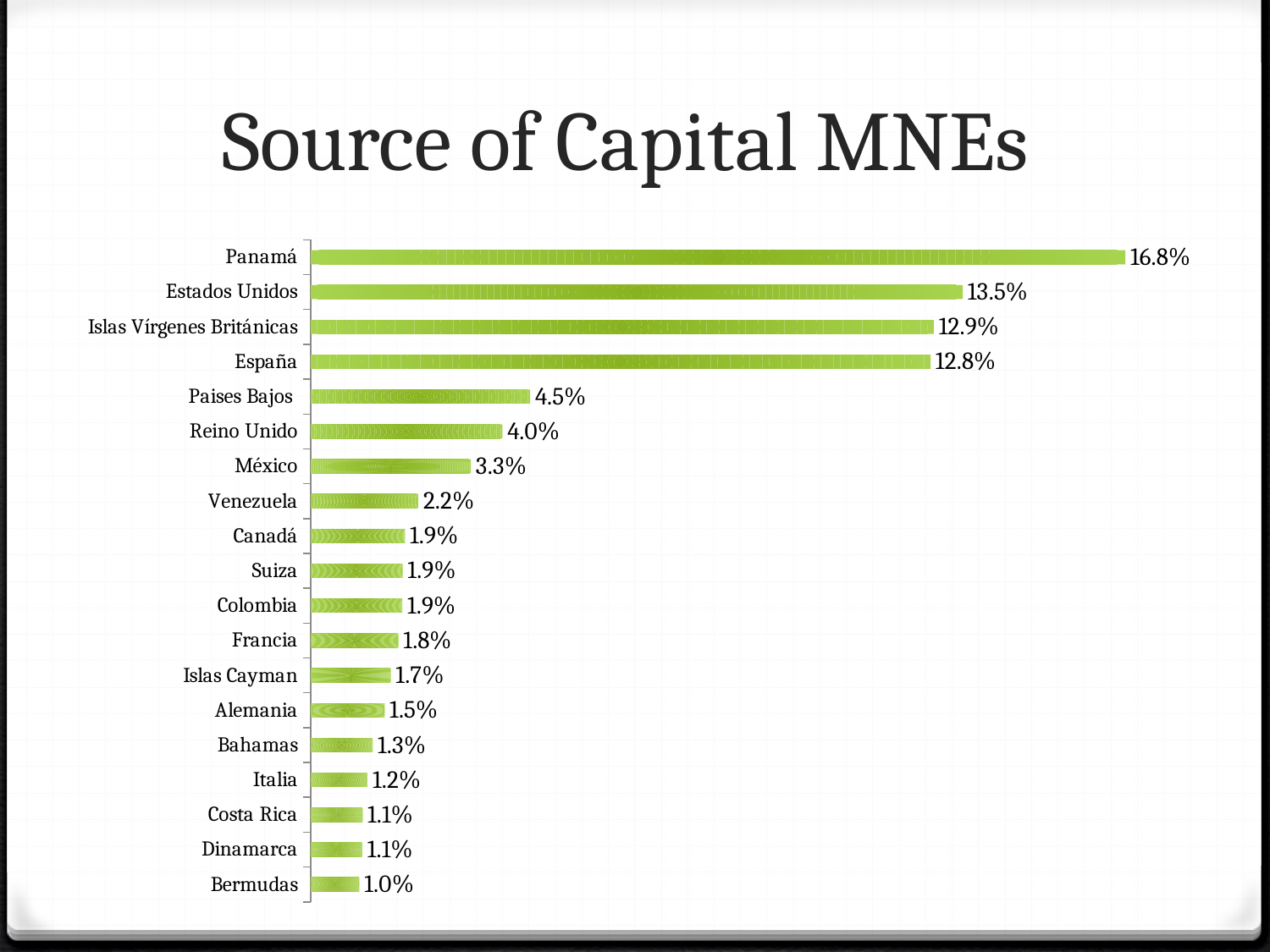
Which category has the highest value? Panamá What is the title of the slide? Source of Capital MNEs What is the value for Islas Cayman? 1.7% What is the difference between the values for Paises Bajos and México? 1.2% What kind of chart is shown on the slide? Bar chart Which category has the lowest value? Bermudas How many categories are shown in the chart? 19 What is the value for Panamá? 16.8% What is the difference between the values for Panamá and Estados Unidos? 3.3% Which is larger, the value for Islas Vírgenes Británicas or the value for España? Islas Vírgenes Británicas What is the value for Estados Unidos? 13.5% What is the value for Reino Unido? 4.0%